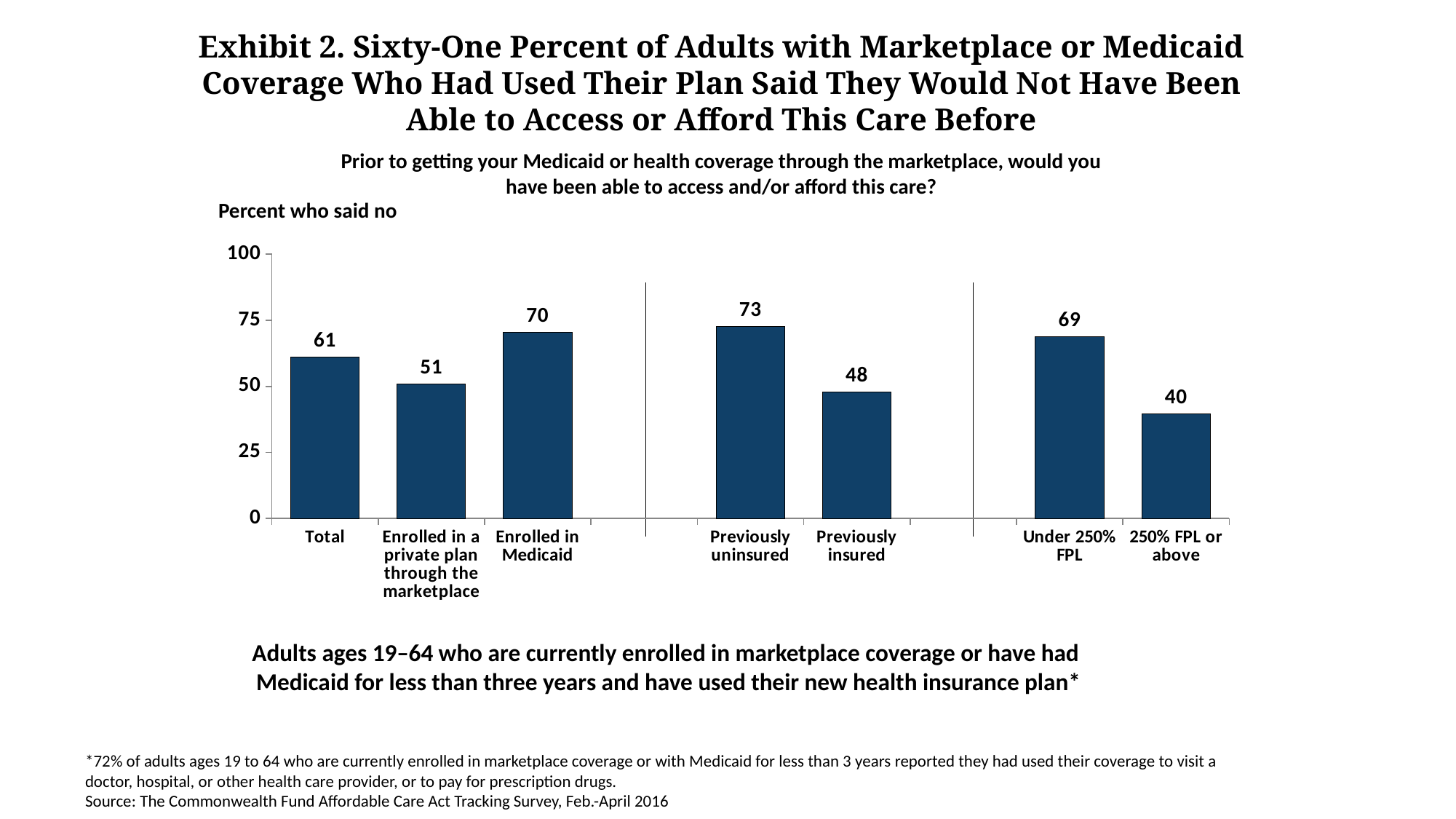
What is the difference between the values for Under 250% FPL and 250% FPL or above? 29 What is the label on the y-axis of the chart? Percent who said no What is the value for adults who were previously insured? 48 What is the value for adults enrolled in Medicaid? 70 How many bars are shown in the chart? 7 What percent of adults in the Total category said no? 61 Which category has the highest percent who said no? Previously uninsured What is the value for adults with income of 250% FPL or above? 40 Which is larger: the value for Enrolled in Medicaid or the value for Enrolled in a private plan through the marketplace? Enrolled in Medicaid What type of chart is shown on the slide? Bar chart Which category has the lowest percent who said no? 250% FPL or above What is the difference between the values for Previously uninsured and Previously insured? 25